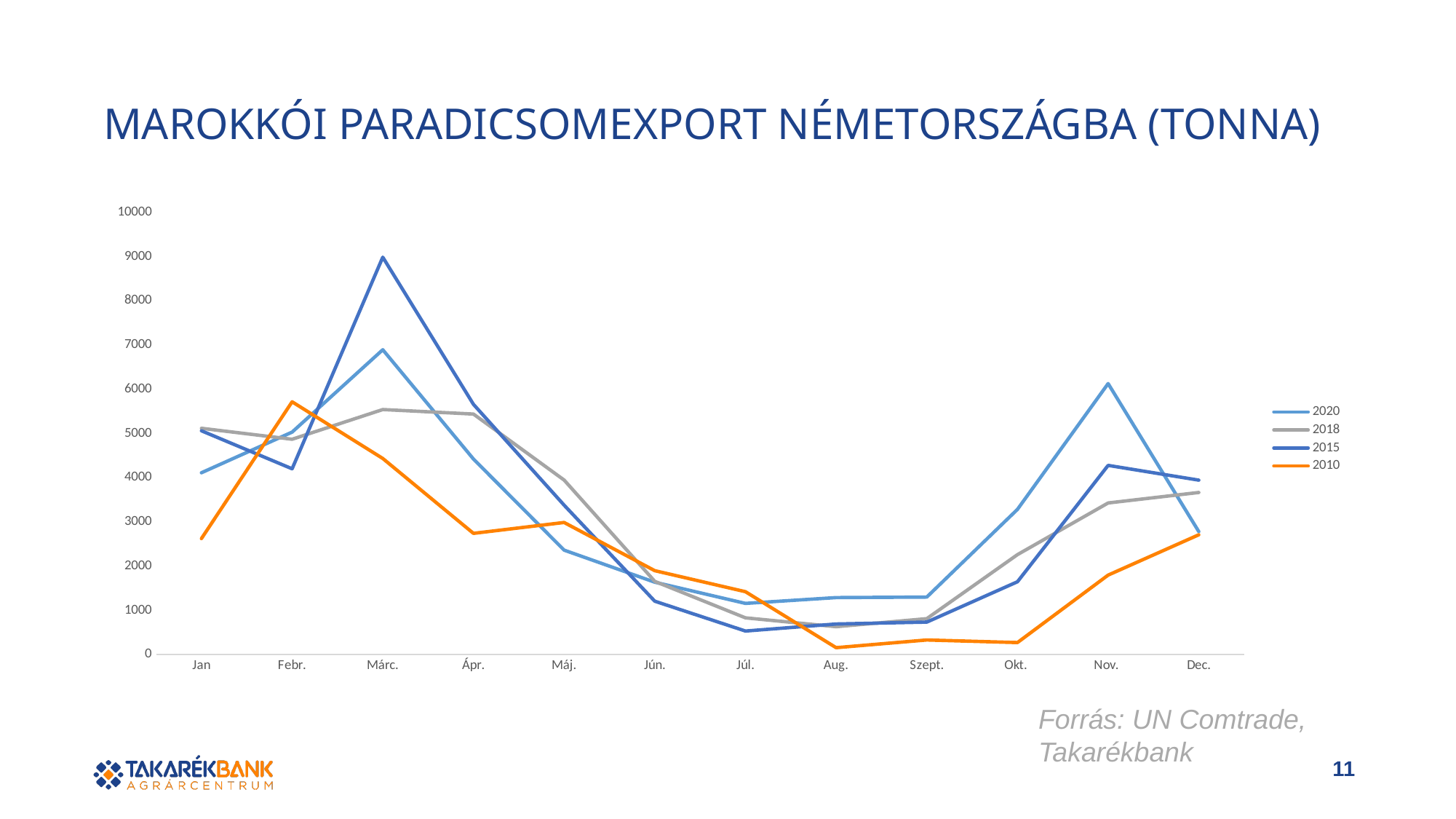
Is the value for 2010 in Aug. greater or less than 1000? less How many months are plotted along the x axis? 12 Is the value for 2015 in Márc. greater or less than 8000? greater Is the value for 2020 in Nov. greater or less than 5000? greater Which series has the larger value in Márc., 2015 or 2020? 2015 How many series does the legend list? 4 In which month does the 2010 series reach its highest value? Febr. What kind of chart is shown on the slide? line chart In which month does the 2015 series reach its highest value? Márc. In which month does the 2010 series reach its lowest value? Aug. What is the title of the chart? MAROKKÓI PARADICSOMEXPORT NÉMETORSZÁGBA (TONNA) Does the 2020 series rise or fall from Márc. to Júl.? fall